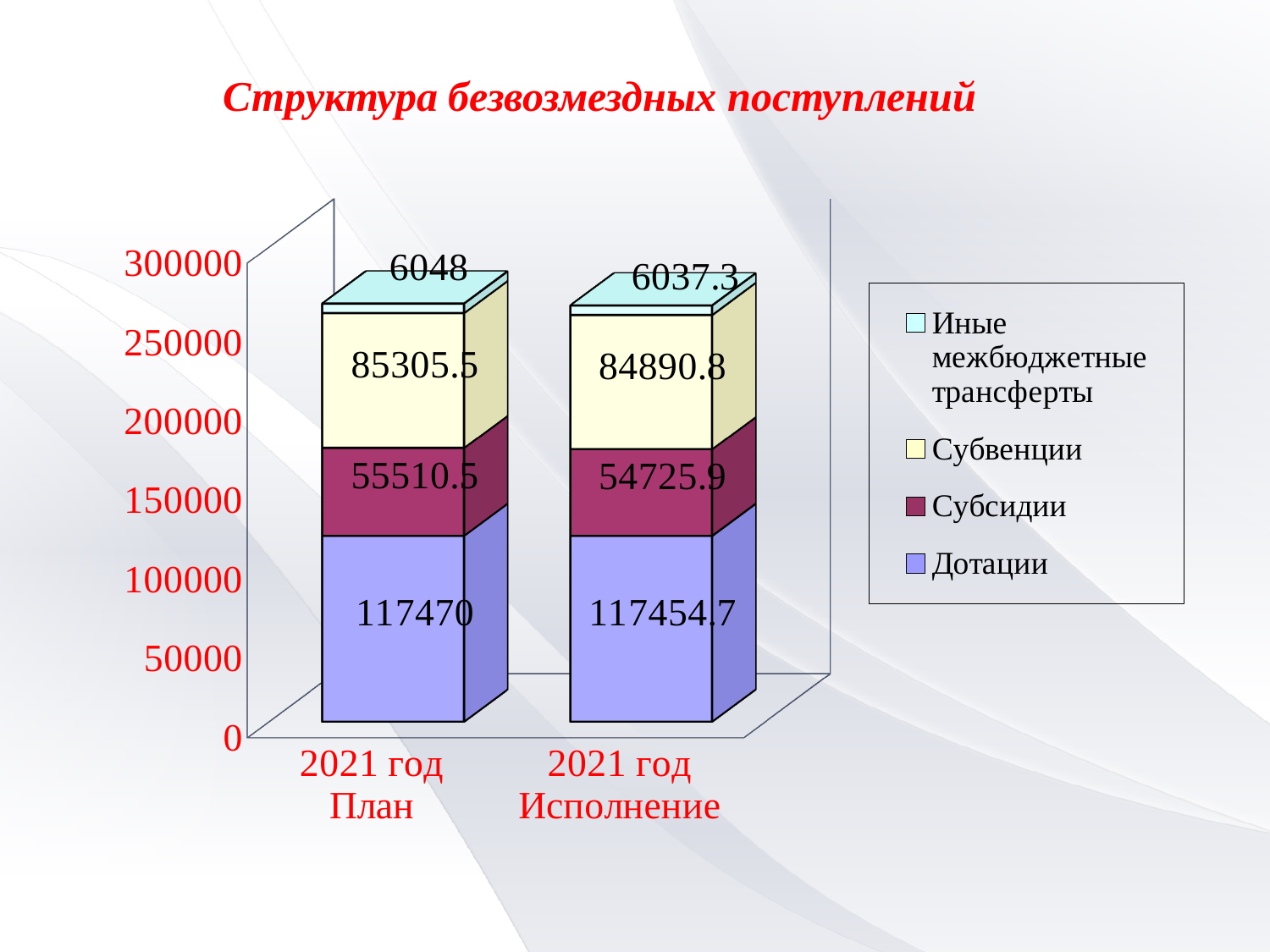
How many categories are shown on the x axis? 2 What is the value of Иные межбюджетные трансферты for 2021 год План? 6048 What is the title of the chart? Структура безвозмездных поступлений What is the value of Субсидии for 2021 год Исполнение? 54725.9 What is the difference between the Субвенции values for 2021 год План and 2021 год Исполнение? 414.7 What is the value of Субвенции for 2021 год Исполнение? 84890.8 What is the value of Дотации for 2021 год План? 117470 What is the total of the stacked bar for 2021 год План? 264334 How many series does the legend list? 4 What type of chart is shown on the slide? stacked bar chart What is the difference between the Субсидии values for 2021 год План and 2021 год Исполнение? 784.6 Which series has the largest value in the 2021 год Исполнение bar? Дотации